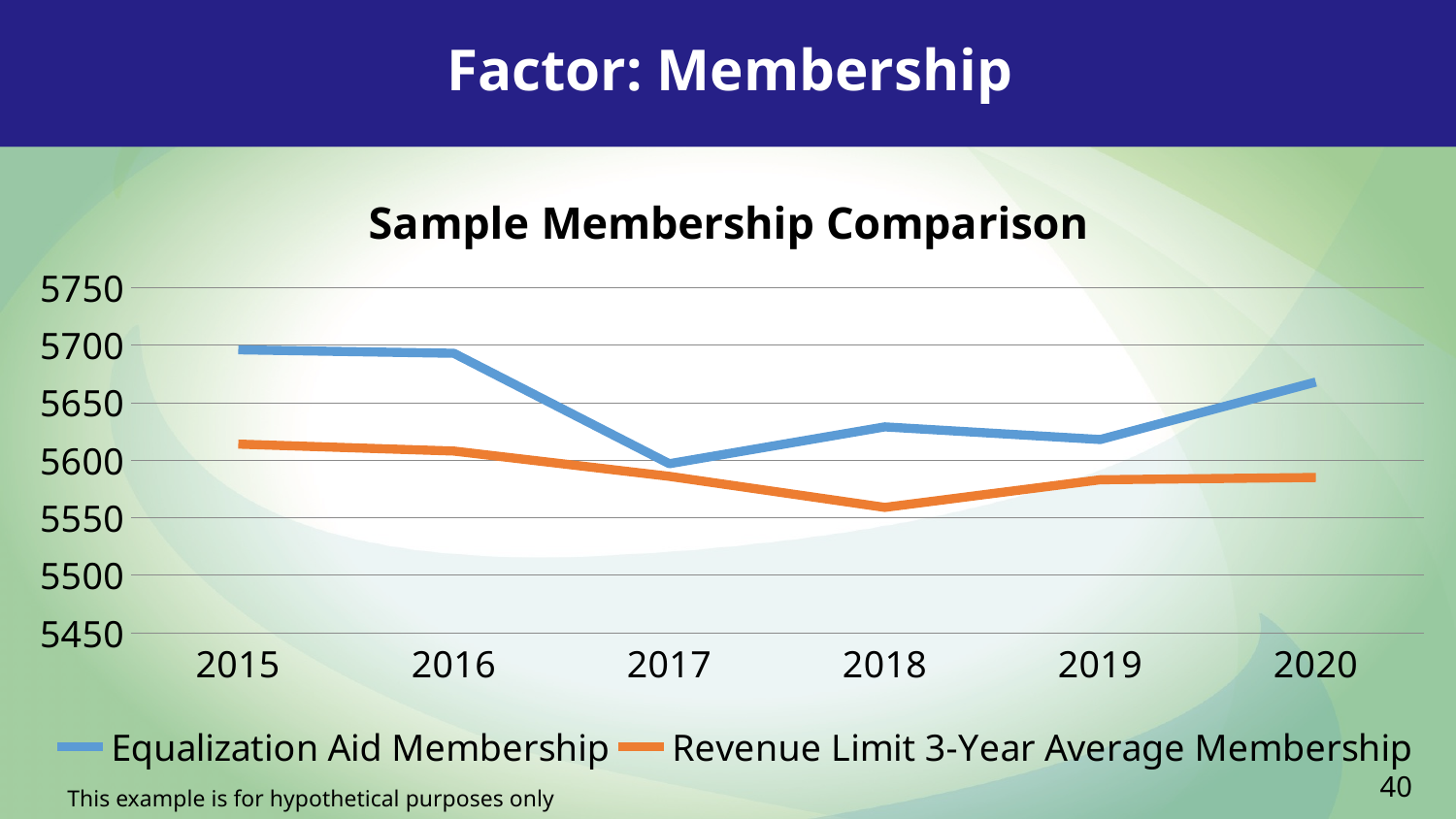
Which series is drawn in orange? Revenue Limit 3-Year Average Membership What is the title of the chart? Sample Membership Comparison Is the value for Revenue Limit 3-Year Average Membership in 2018 greater or less than 5600? less In which year is Revenue Limit 3-Year Average Membership at its lowest? 2018 In which year is Equalization Aid Membership at its lowest? 2017 What kind of chart is shown on the slide? line chart How many years are plotted along the x axis? 6 Is the value for Equalization Aid Membership in 2017 greater or less than 5650? less Does Revenue Limit 3-Year Average Membership rise or fall from 2015 to 2018? fall Is the value for Equalization Aid Membership in 2015 greater or less than 5650? greater In 2017, which series has the higher value, Equalization Aid Membership or Revenue Limit 3-Year Average Membership? Equalization Aid Membership How many series does the legend list? 2